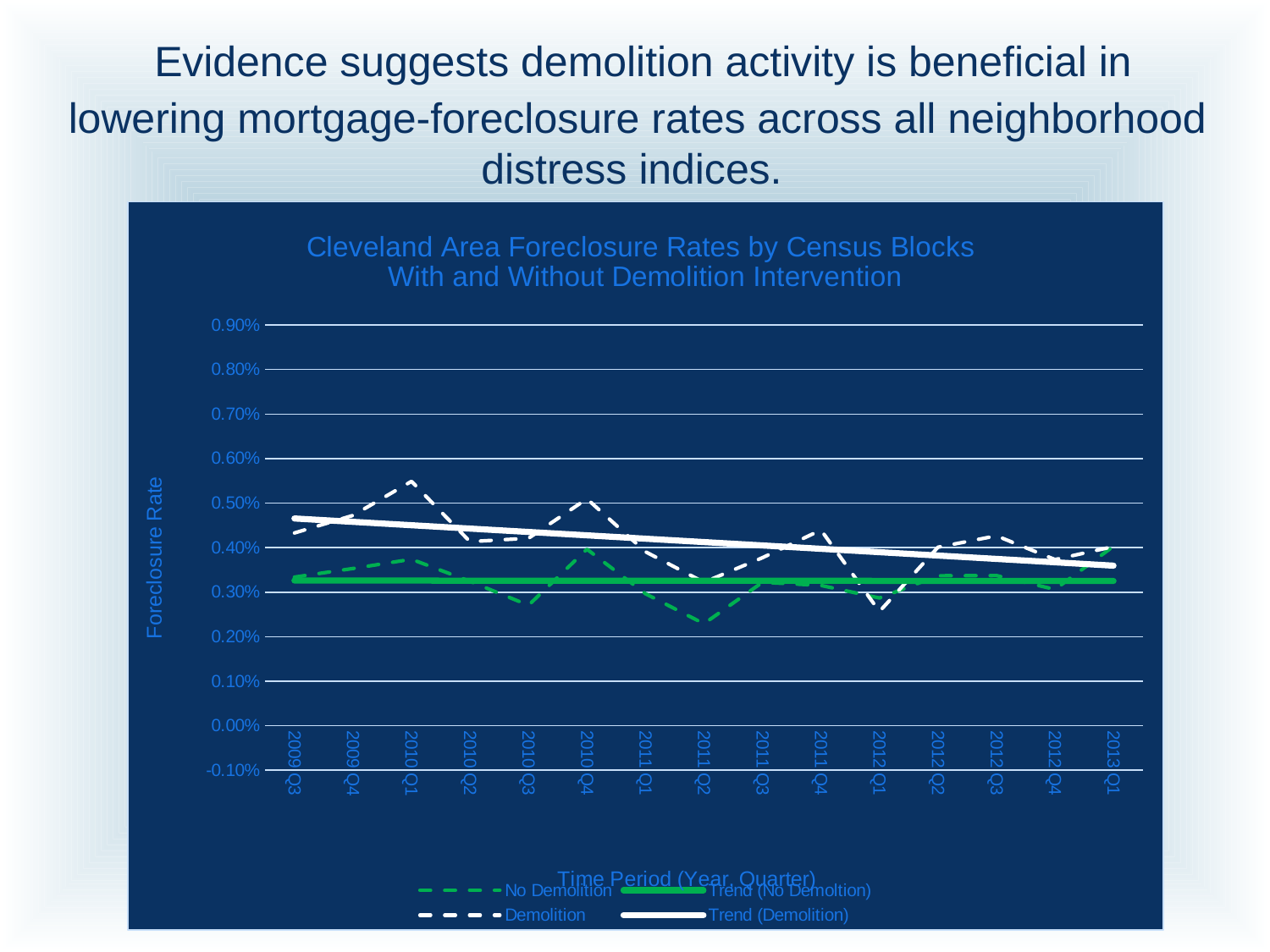
How many entries does the chart's legend list? 4 What kind of chart is shown on the slide? Line chart Does the Trend (Demolition) line rise or fall from 2009 Q3 to 2013 Q1? Fall What is the title of the chart? Cleveland Area Foreclosure Rates by Census Blocks With and Without Demolition Intervention At 2010 Q1, which series has the higher value, Demolition or No Demolition? Demolition What is the label of the vertical axis? Foreclosure Rate Is the Demolition value for 2010 Q1 greater or less than 0.50%? greater In which time period does the Demolition series reach its highest value? 2010 Q1 In which time period does the No Demolition series reach its lowest value? 2011 Q2 How many time periods are shown along the x axis of the chart? 15 Is the No Demolition value for 2011 Q2 greater or less than 0.30%? less Is the Trend (No Demolition) line above or below 0.40% across the chart? below